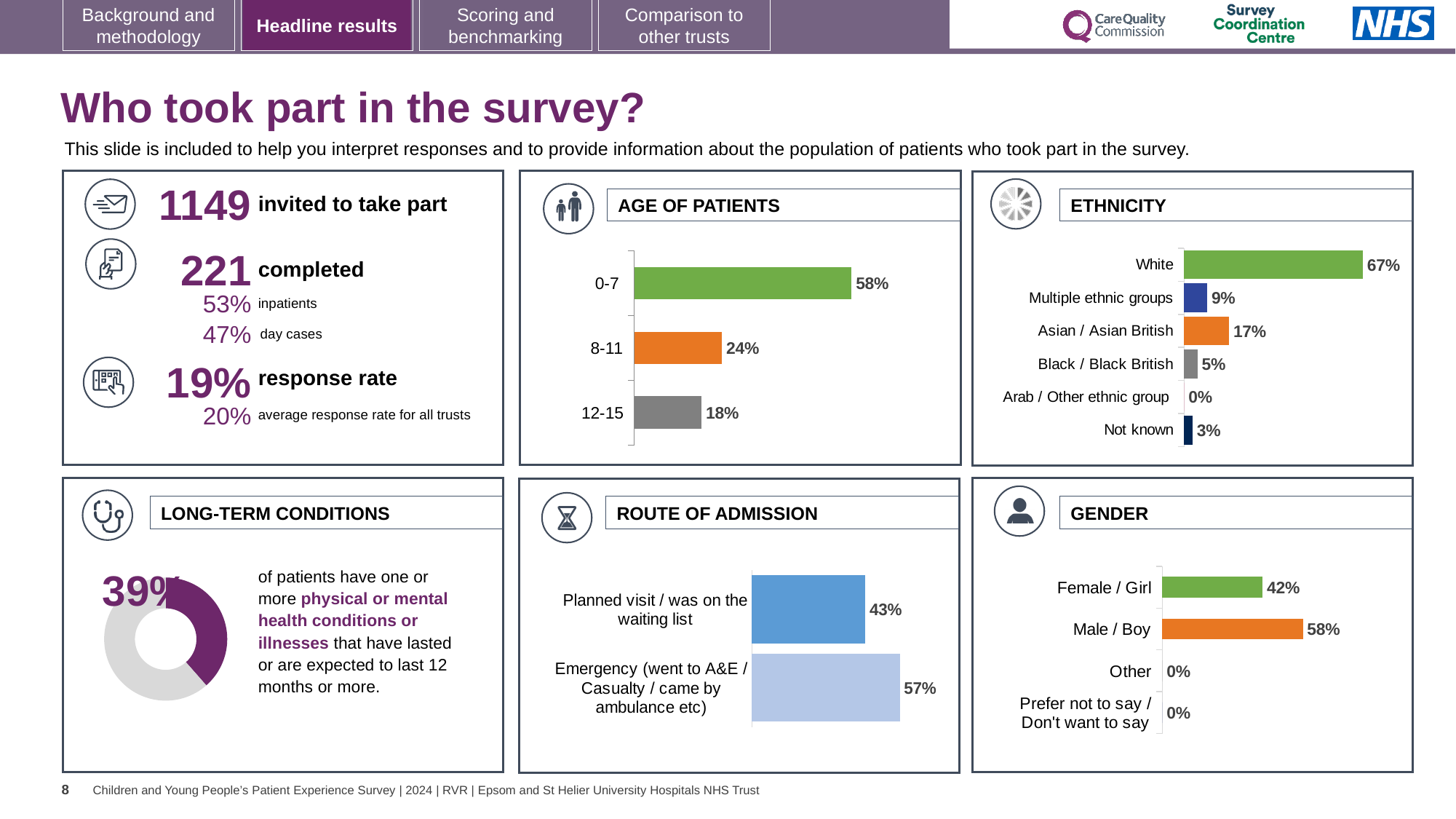
In the ROUTE OF ADMISSION chart, what is the difference between the Emergency and Planned visit values? 14% In the ETHNICITY chart, which category has the highest value? White In the AGE OF PATIENTS chart, which age group has the lowest value? 12-15 How many categories are shown in the ETHNICITY chart? 6 In the AGE OF PATIENTS chart, what is the value for the 0-7 age group? 58% In the ETHNICITY chart, what is the value for Asian / Asian British? 17% In the ETHNICITY chart, which is larger: Multiple ethnic groups or Black / Black British? Multiple ethnic groups In the GENDER chart, what is the value for Male / Boy? 58% What kind of chart is the LONG-TERM CONDITIONS chart? Doughnut chart In the GENDER chart, which is larger: Female / Girl or Male / Boy? Male / Boy In the ROUTE OF ADMISSION chart, what is the value for Emergency (went to A&E / Casualty / came by ambulance etc)? 57% In the AGE OF PATIENTS chart, what is the difference between the 0-7 and 8-11 values? 34%